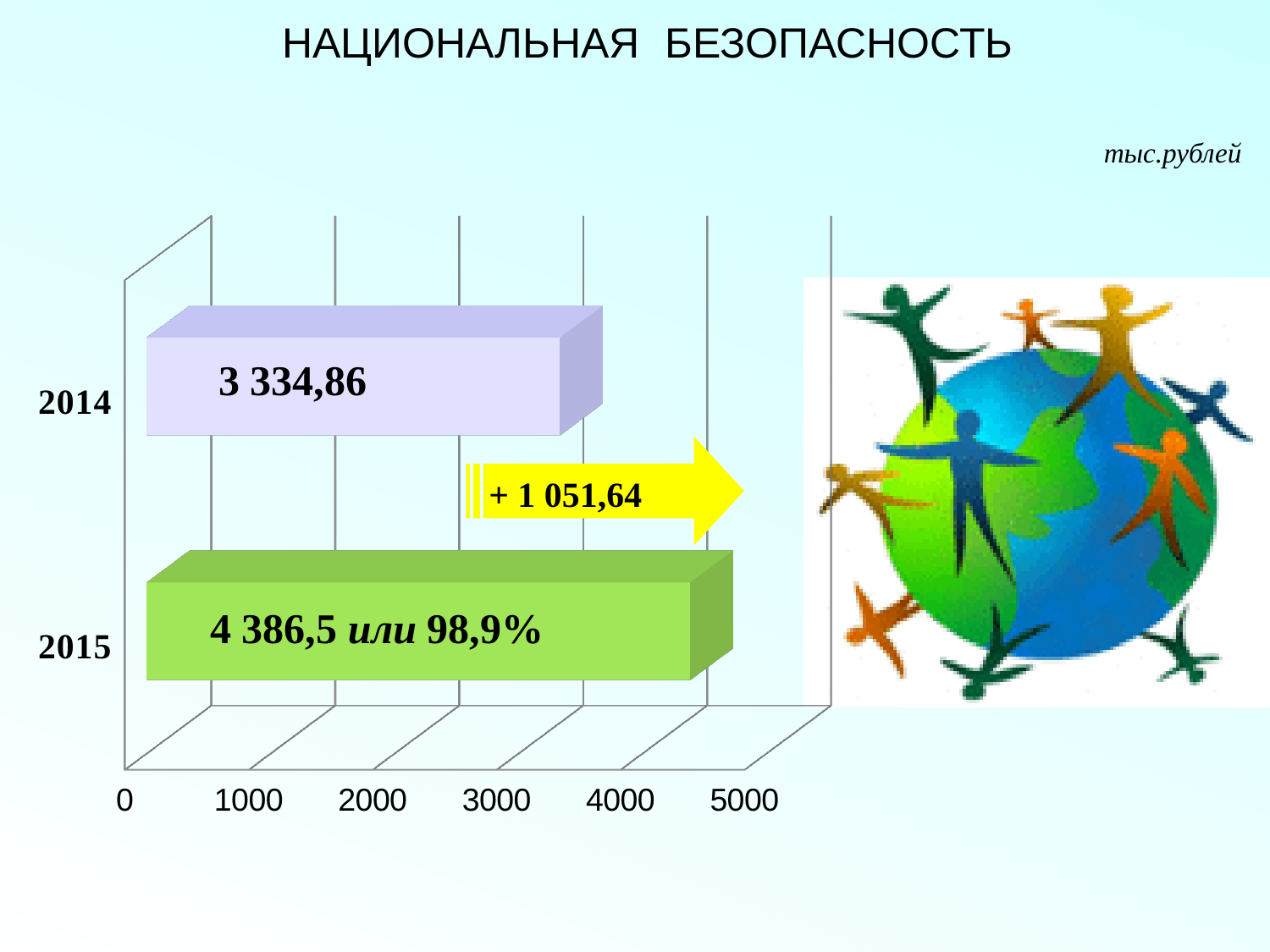
Which year has the lower value? 2014 Is the value for 2015 larger than the value for 2014? Yes Is the value for 2015 greater or less than 4000? greater What is the title of the slide? НАЦИОНАЛЬНАЯ БЕЗОПАСНОСТЬ What is the value for 2014? 3 334,86 Which year has the higher value? 2015 What is the value for 2015? 4 386,5 What is the difference between the 2015 and 2014 values? 1 051,64 What kind of chart is shown on the slide? Bar chart What unit is indicated for the chart values? тыс.рублей Is the value for 2014 greater or less than 4000? less How many years are shown on the chart? 2